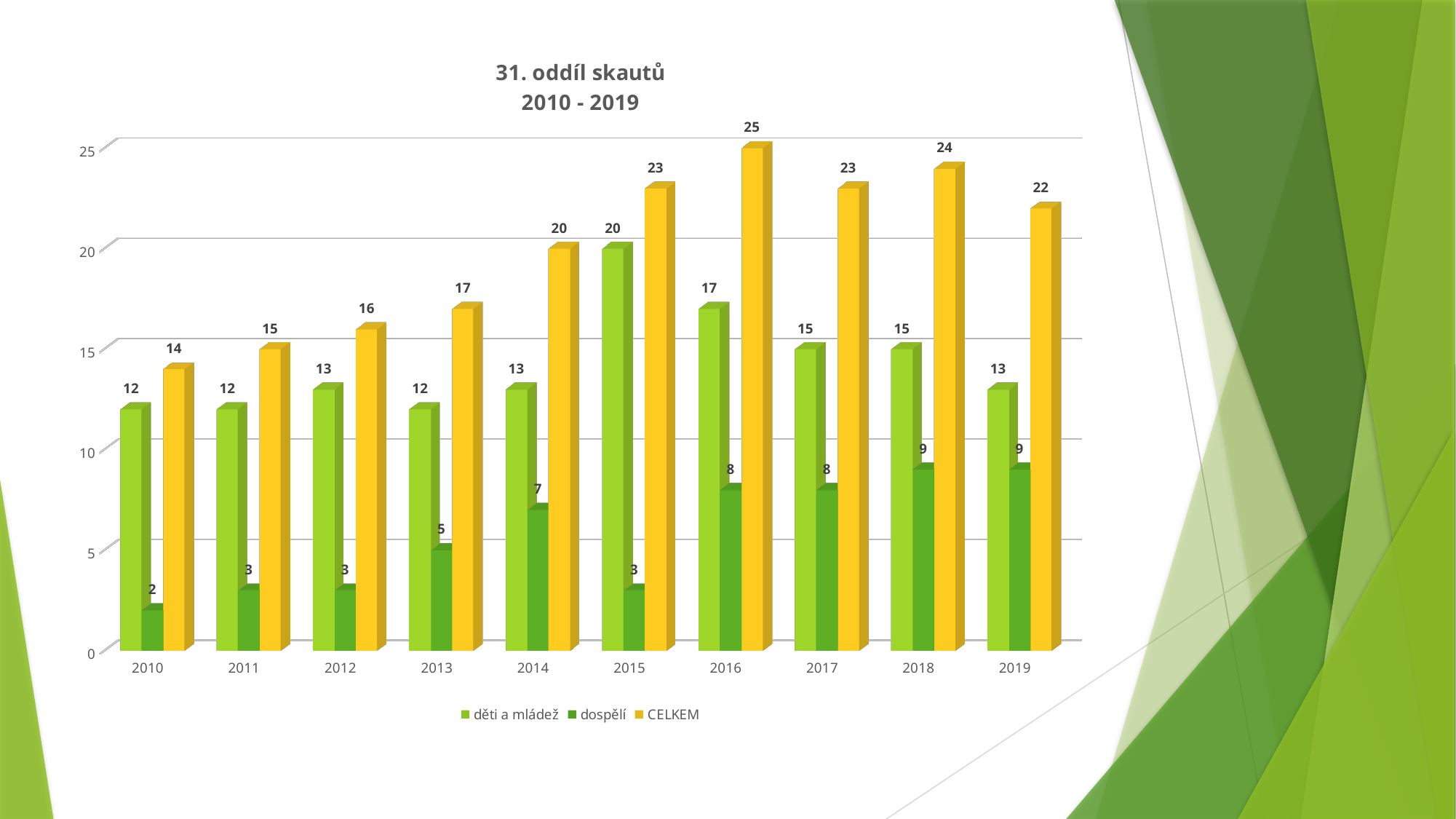
How many years are shown on the x axis? 10 How many series does the legend list? 3 What is the CELKEM value for 2019? 22 What kind of chart is shown on the slide? bar chart What is the difference between the CELKEM values for 2016 and 2010? 11 Is the CELKEM value for 2013 greater or less than 15? greater In which year is the dospělí value lowest? 2010 What is the value for děti a mládež in 2015? 20 Which is larger: děti a mládež in 2016 or děti a mládež in 2018? děti a mládež in 2016 What is the title of the chart? 31. oddíl skautů 2010 - 2019 In which year is the CELKEM value highest? 2016 What is the value for dospělí in 2014? 7